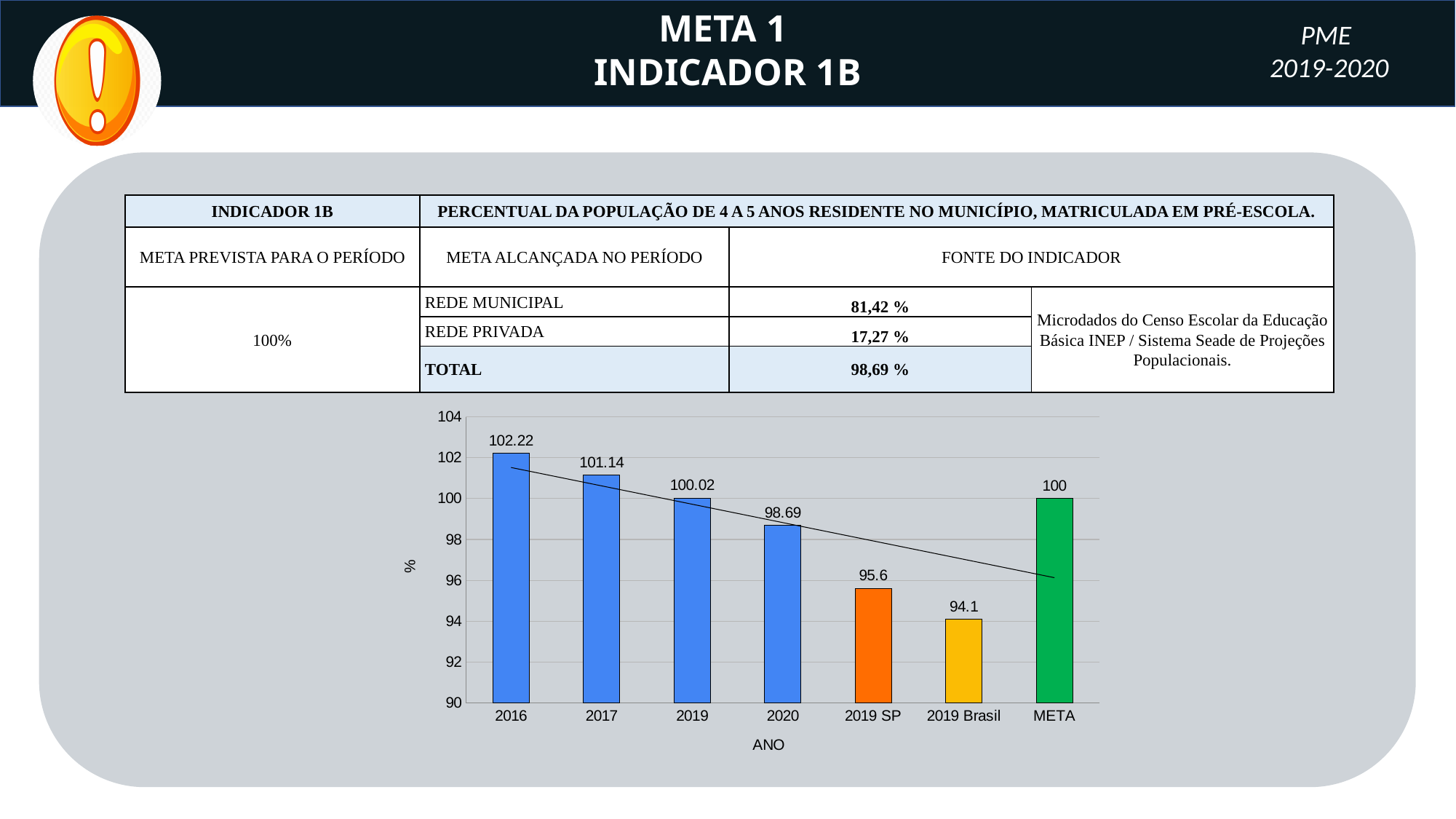
Which category has the highest value in the chart? 2016 What is the difference between the values for 2016 and 2017? 1.08 Which category has the lowest value in the chart? 2019 Brasil How many bars are shown in the chart? 7 What is the difference between the META value and the 2019 SP value? 4.4 What kind of chart is shown on the slide? bar chart Which is larger, the value for 2019 or the value for 2020? 2019 What is the value for 2019 Brasil in the chart? 94.1 What is the value for 2020 in the chart? 98.69 Is the value for 2019 SP greater or less than 96? less What is the label of the x axis of the chart? ANO What is the value for 2016 in the chart? 102.22